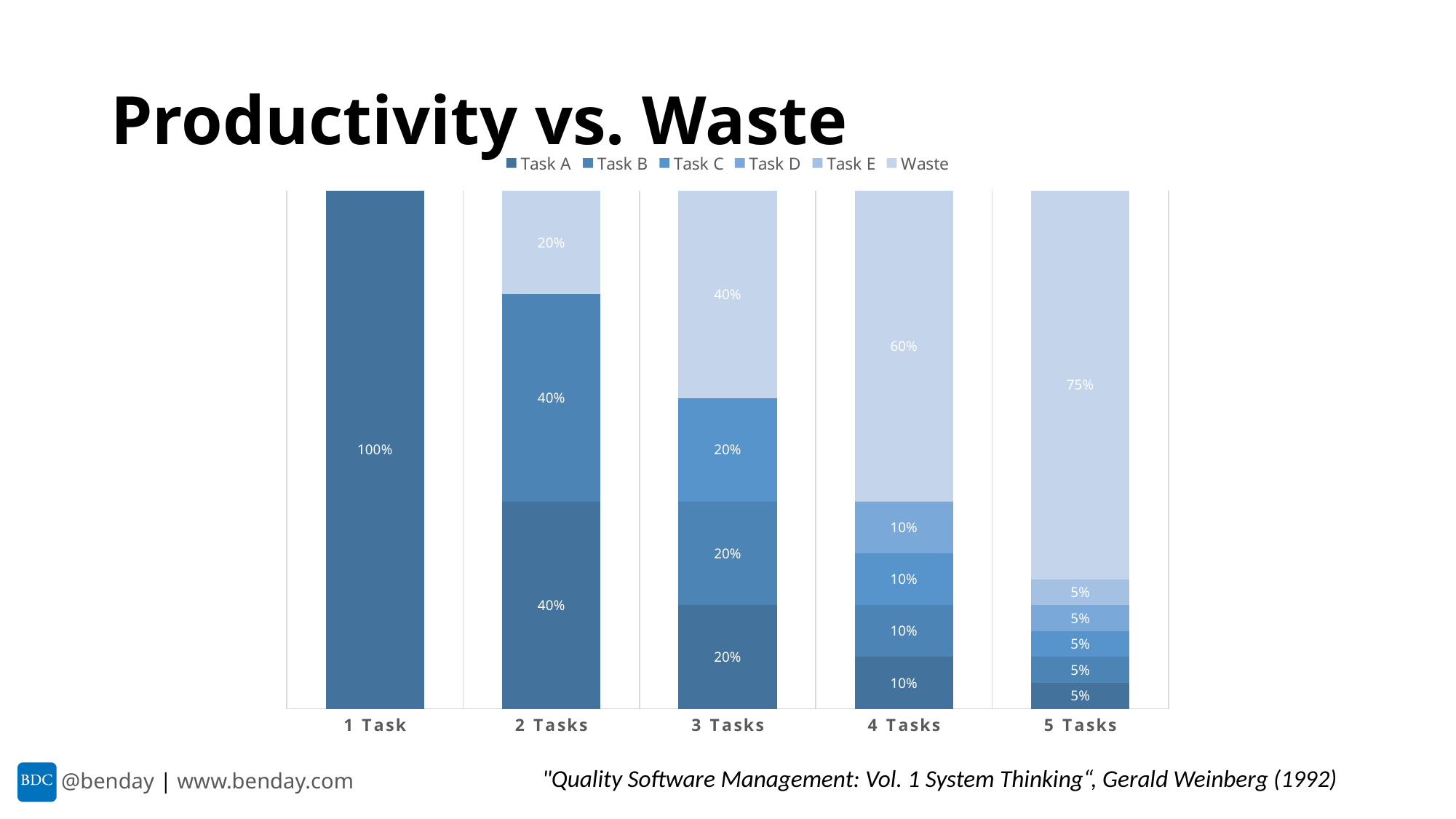
Which category has the smallest Task A segment? 5 Tasks What kind of chart is shown on the slide? Stacked bar chart Which is larger: the Task A value for 2 Tasks or the Task A value for 3 Tasks? 2 Tasks What is the Task E value for 5 Tasks? 5% What is the Task A value for 3 Tasks? 20% What is the Waste value for 4 Tasks? 60% What is the difference between the Waste value for 5 Tasks and the Waste value for 4 Tasks? 15% Which category has the largest Waste segment? 5 Tasks Does the Waste value rise or fall as the number of tasks increases from 2 Tasks to 5 Tasks? Rise How many series does the legend list? 6 How many categories are shown on the x axis? 5 What is the total of the stacked bar for 5 Tasks? 100%